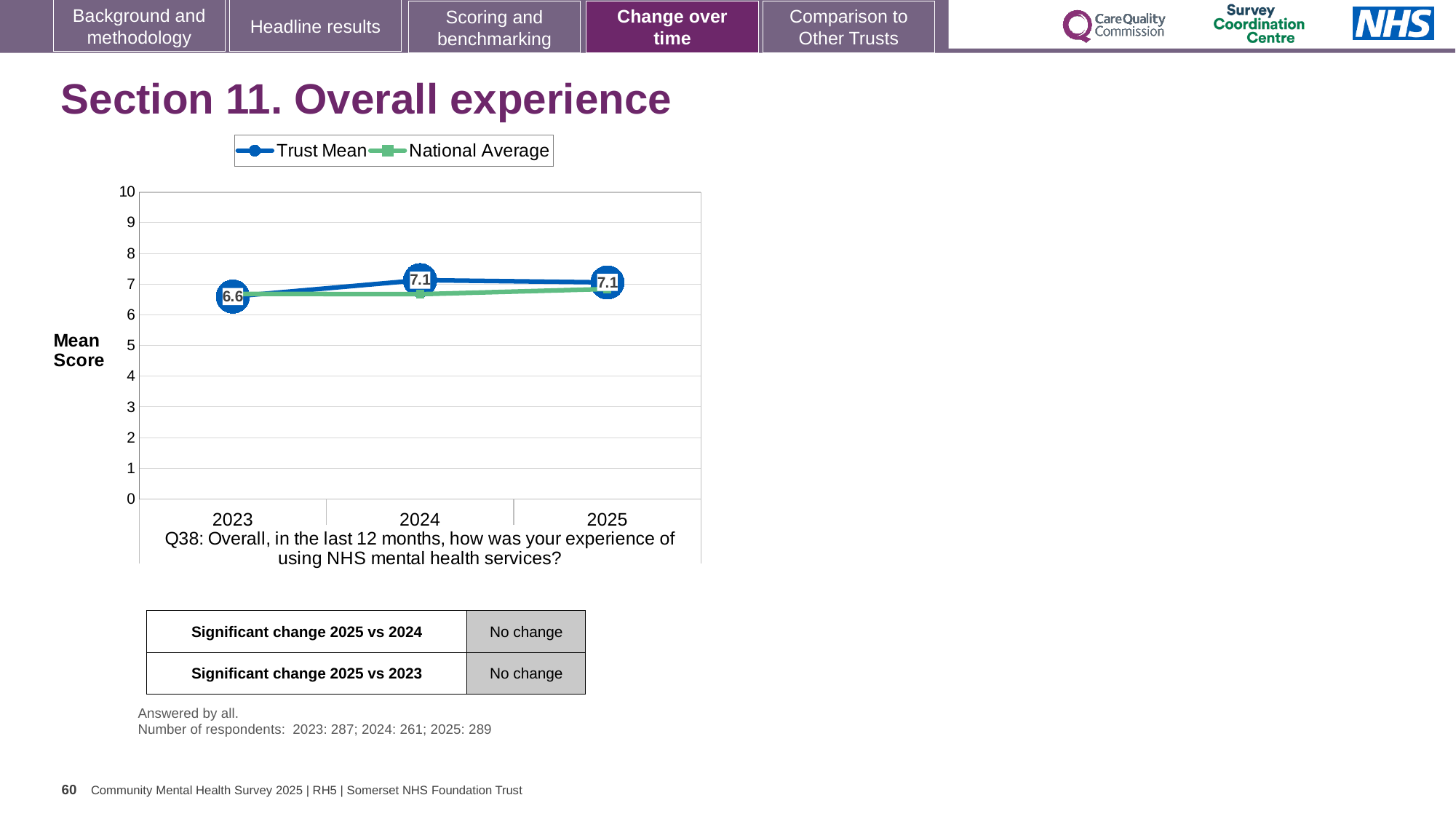
How many series does the legend list? 2 By how much did the Trust Mean score change from 2023 to 2024? 0.5 What is the Trust Mean score for 2024? 7.1 Is the National Average value for 2025 greater or less than 5? greater How many years are plotted on the x axis? 3 In which year is the Trust Mean score lowest? 2023 Is the National Average value for 2023 greater or less than 8? less What is the Trust Mean score for 2023? 6.6 What kind of chart is shown on the slide? line chart Does the Trust Mean score rise or fall from 2023 to 2025? rise What is the Trust Mean score for 2025? 7.1 What is the label on the y axis of the chart? Mean Score